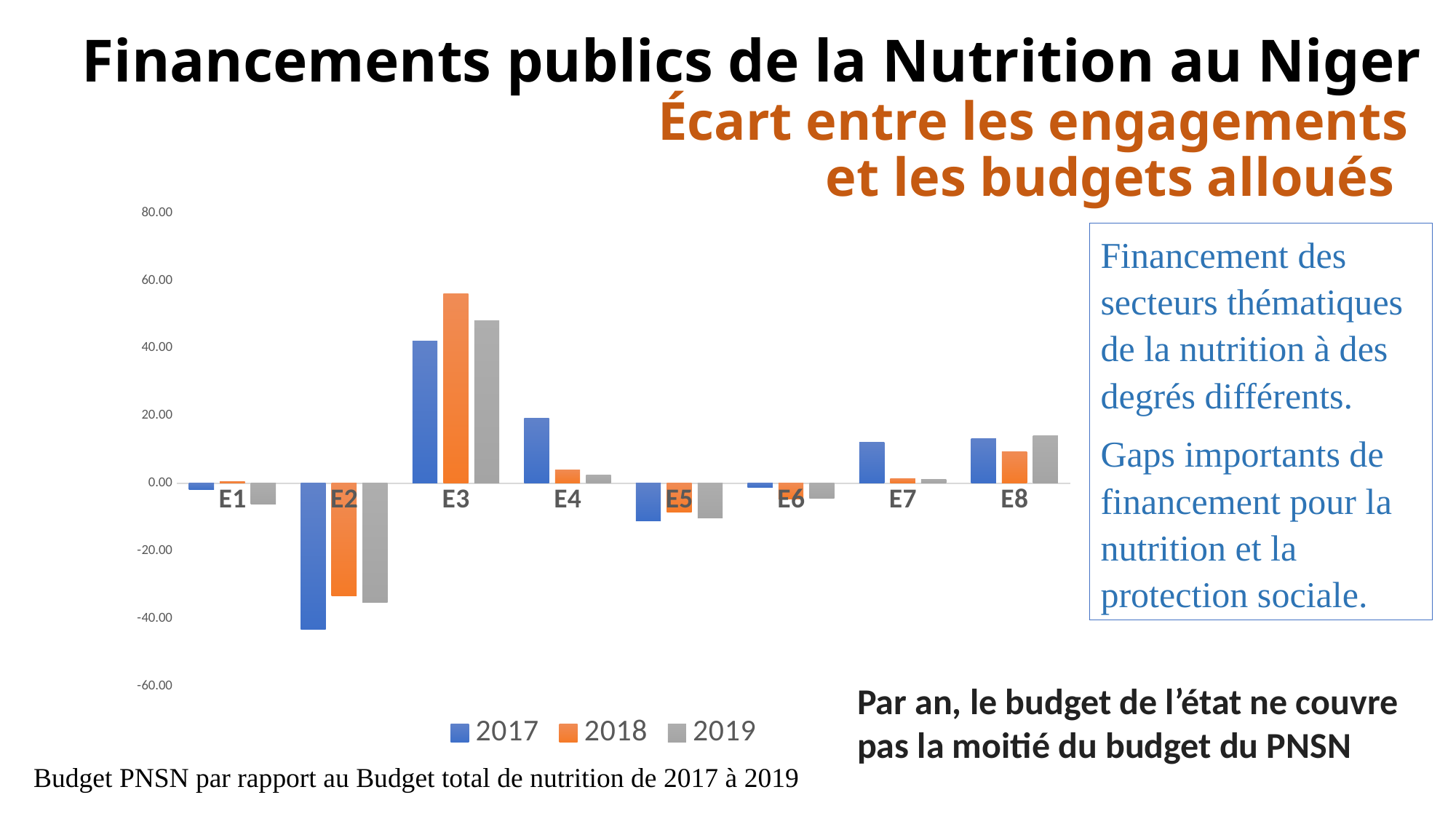
Which category has the lowest bar for the 2017 series? E2 Is the 2017 value for E2 greater or less than -40? less For E4, which series has the larger value, 2017 or 2019? 2017 Which category has the highest bar for the 2018 series? E3 What kind of chart is shown on the slide? bar chart Is the 2019 value for E3 greater or less than 40? greater For E3, which series has the larger value, 2017 or 2018? 2018 Is the 2018 value for E3 greater or less than 40? greater Which series is shown in orange in the chart legend? 2018 How many series does the chart legend list? 3 How many categories are shown on the x axis of the chart? 8